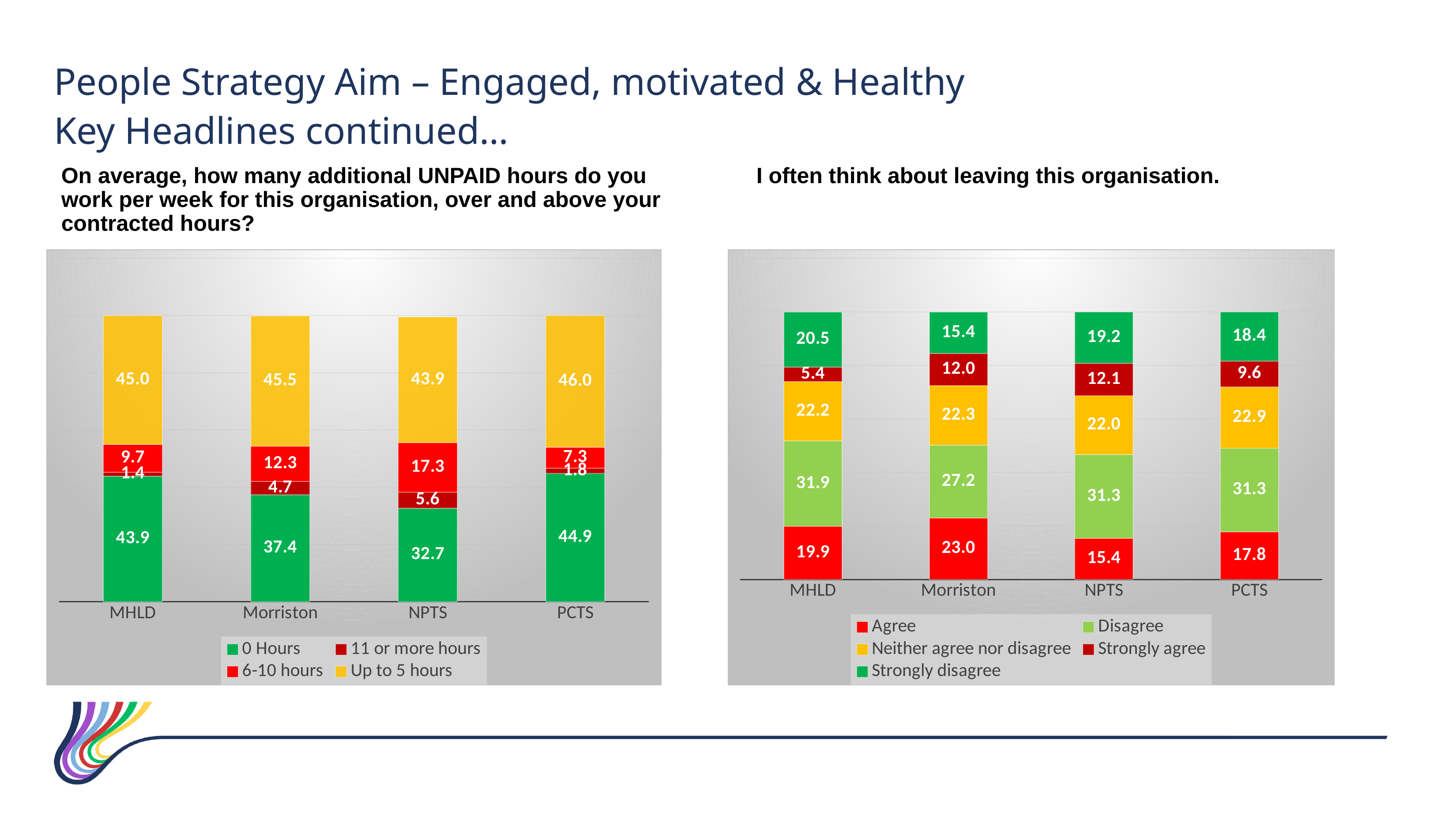
In the right chart (I often think about leaving this organisation), is the Strongly disagree value larger for MHLD or for Morriston? MHLD In the left chart (unpaid hours), what is the difference between the 0 Hours values for PCTS and Morriston? 7.5 In the left chart (unpaid hours), what is the value for 0 Hours at NPTS? 32.7 In the right chart (I often think about leaving this organisation), which organisation has the lowest Agree value? NPTS In the left chart (unpaid hours), which organisation has the highest value for 6-10 hours? NPTS In the left chart (unpaid hours), what is the value for Up to 5 hours at PCTS? 46.0 In the right chart (I often think about leaving this organisation), what is the Strongly agree value for Morriston? 12.0 In the right chart (I often think about leaving this organisation), what is the total of the stacked bar for MHLD? 99.9 In the left chart (unpaid hours), which organisation has the lowest value for 11 or more hours? MHLD What type of chart is the right chart (I often think about leaving this organisation)? Stacked bar chart In the left chart (unpaid hours), how many series does the legend list? 4 In the right chart (I often think about leaving this organisation), how many organisations are shown on the x axis? 4